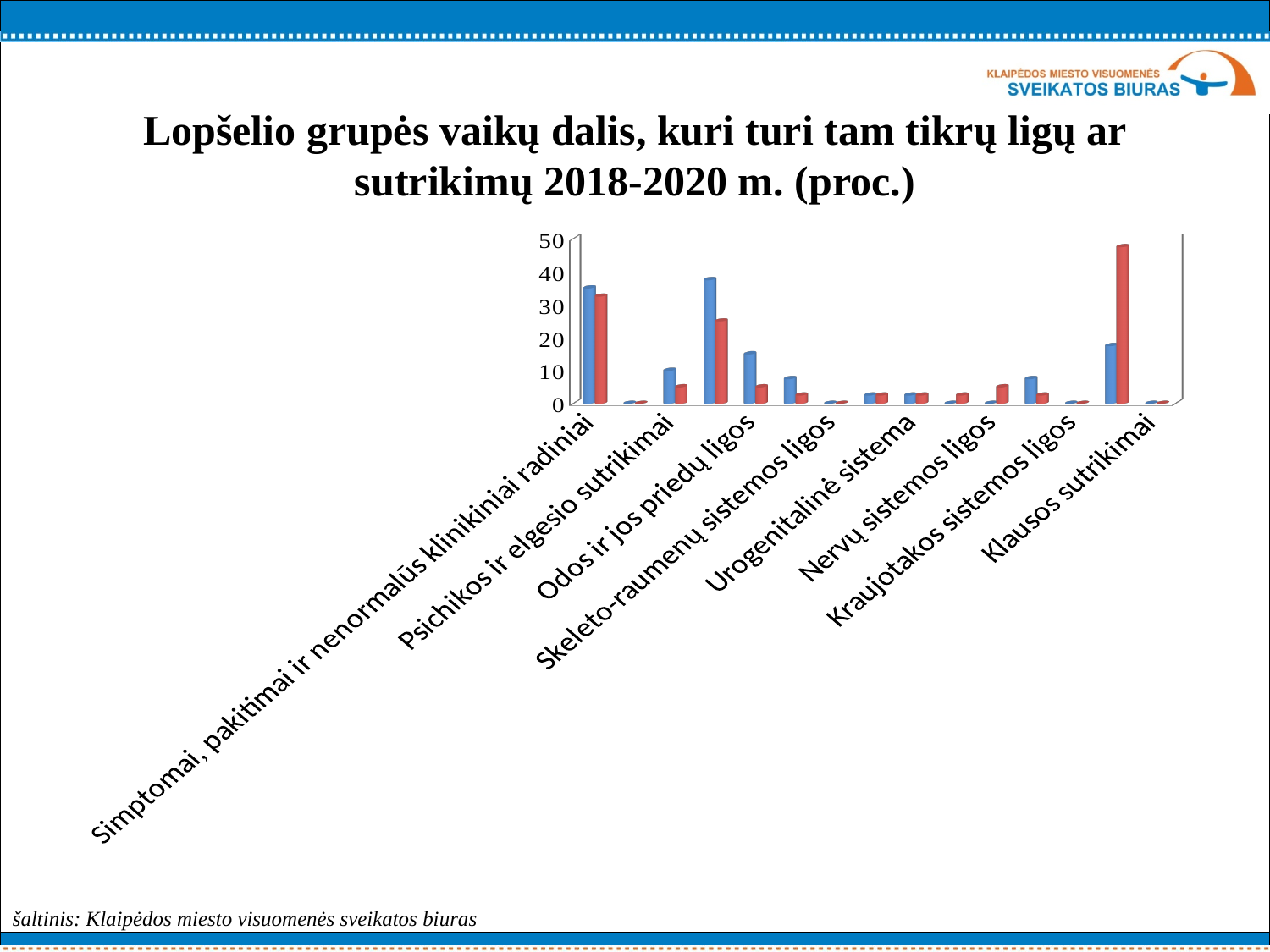
Is the red bar for 'Simptomai, pakitimai ir nenormalūs klinikiniai radiniai' greater or less than 30? greater Is the blue bar for 'Simptomai, pakitimai ir nenormalūs klinikiniai radiniai' greater or less than 30? greater What is the title of the chart? Lopšelio grupės vaikų dalis, kuri turi tam tikrų ligų ar sutrikimų 2018-2020 m. (proc.) Is the tallest bar in the chart greater or less than 40? greater What is the highest value shown on the vertical axis? 50 How many bar colours (series) are plotted in the chart? 2 What kind of chart is shown on the slide? bar chart